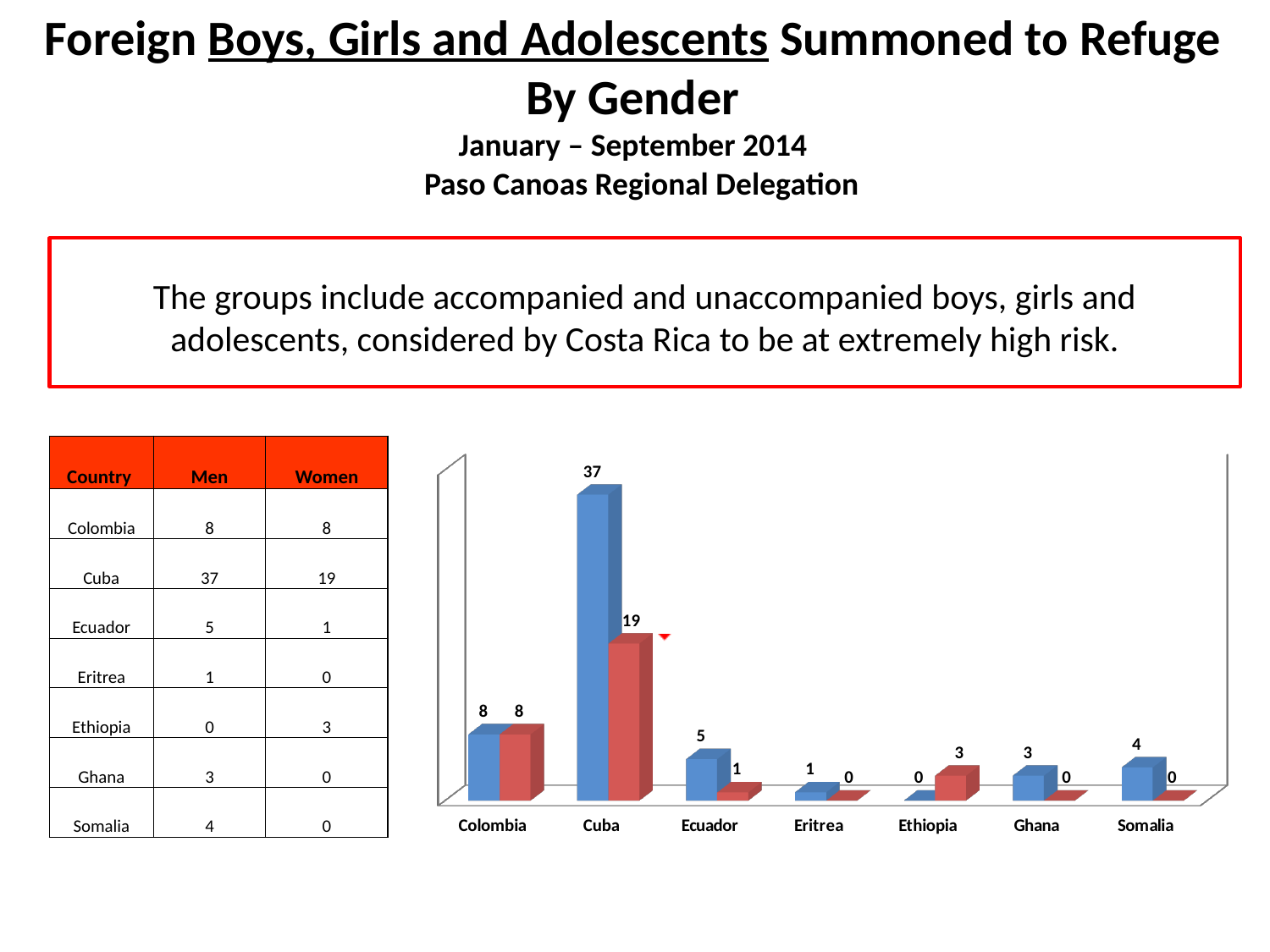
Which is larger for Ecuador, the Men value or the Women value? Men Which colour represents the Men series in the chart? blue What is the difference between the Men and Women values for Cuba? 18 What is the value for Men in Somalia? 4 What is the value for Women in Cuba? 19 What is the total of Men and Women for Colombia? 16 Which country has the highest value for Men? Cuba What kind of chart is shown on the slide? bar chart What is the value for Men in Cuba? 37 What is the value for Women in Ethiopia? 3 How many countries are shown on the x axis of the chart? 7 Which country has the lowest value for Men? Ethiopia